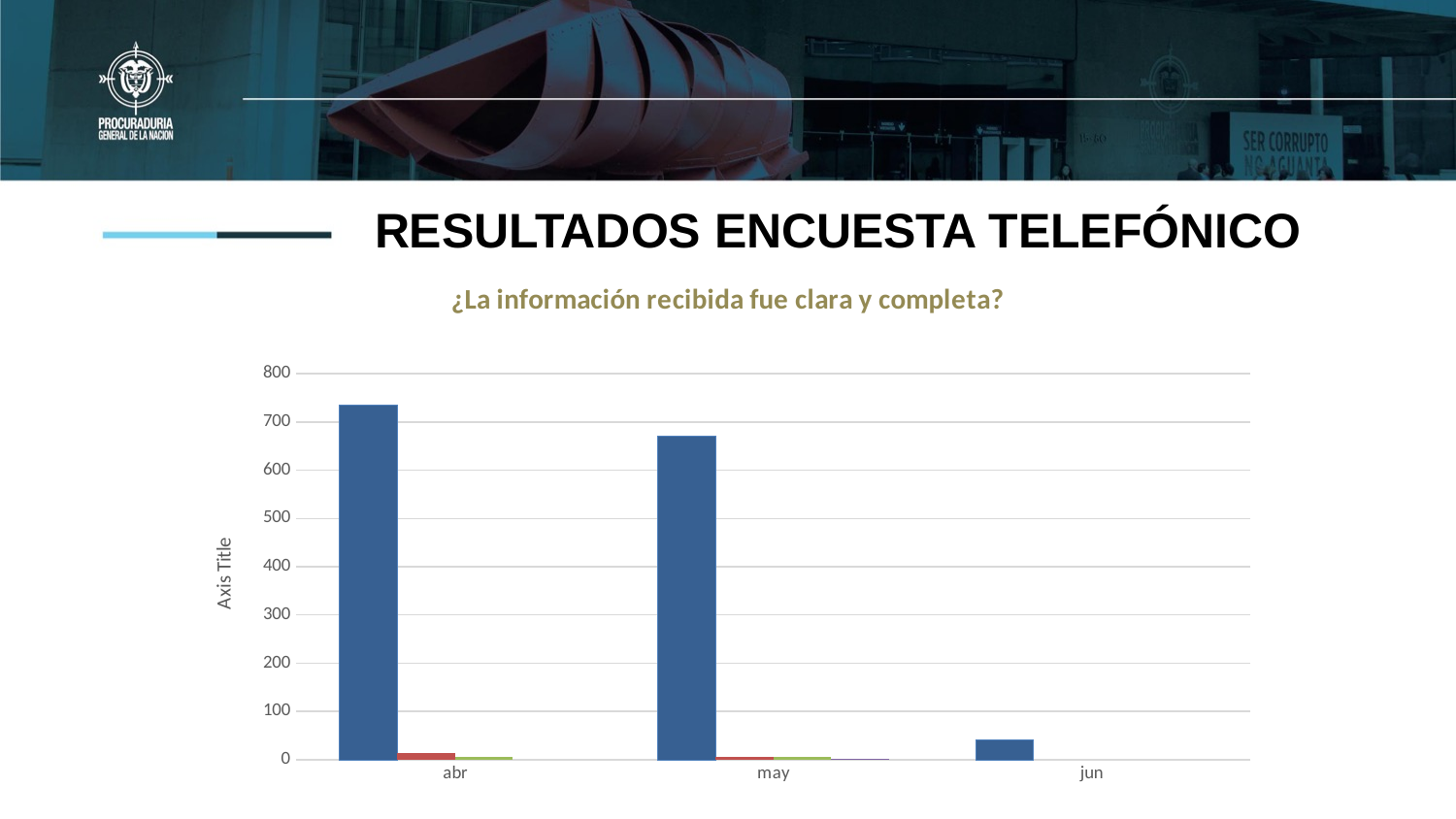
Is the blue bar for may greater or less than 600? greater What is the title of the chart? ¿La información recibida fue clara y completa? Which category has the shortest blue bar? jun Is the blue bar for abr greater or less than 700? greater Do the blue bars rise or fall from abr to jun? fall Is the blue bar for may greater or less than 700? less What is the label on the vertical axis? Axis Title How many categories are shown on the x axis? 3 Which is larger, the blue bar for abr or the blue bar for may? abr What kind of chart is shown on the slide? bar chart Which category has the tallest blue bar? abr